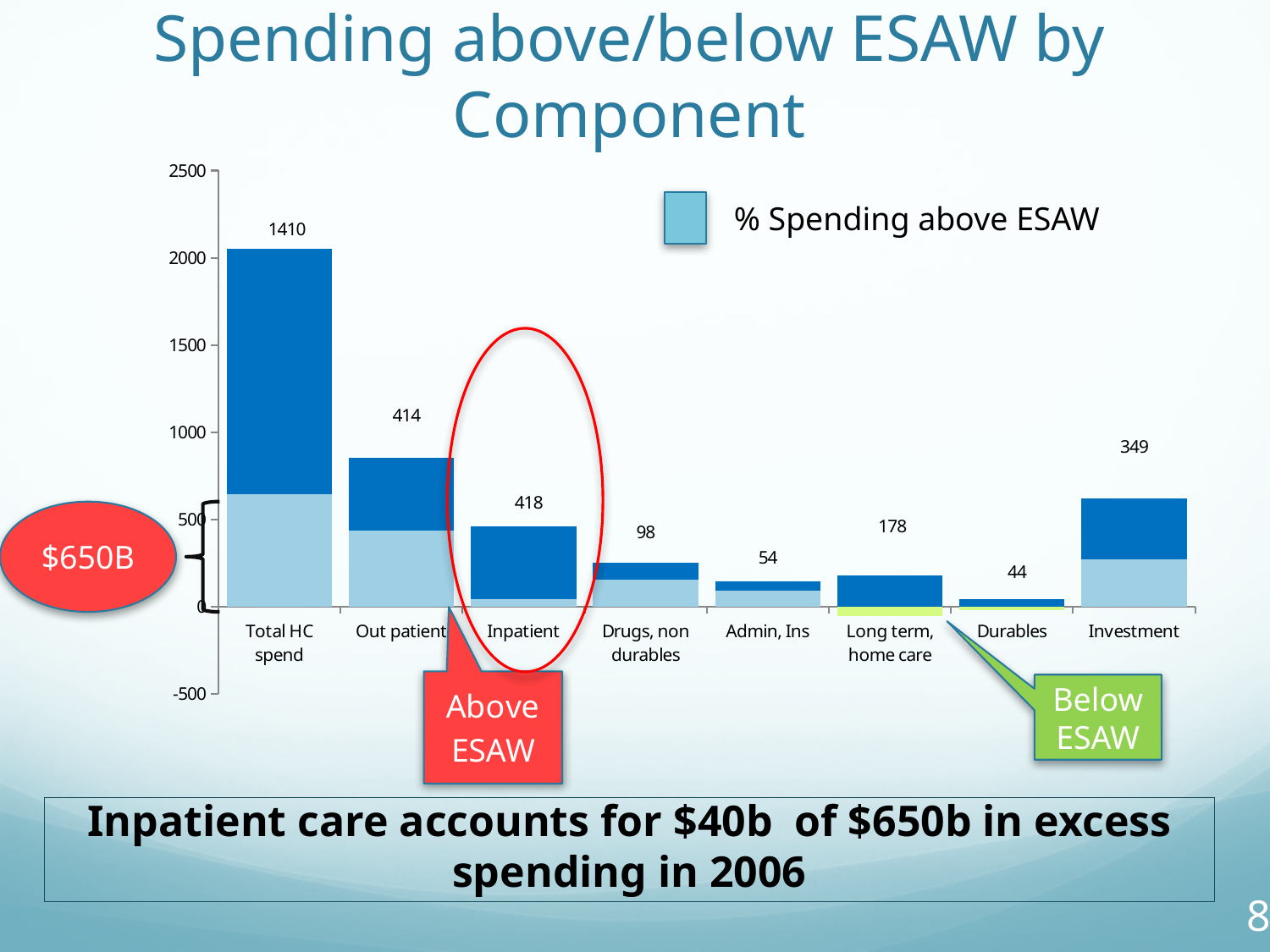
What is the title of the chart on the slide? Spending above/below ESAW by Component What is the difference between the labelled values for Investment and Long term, home care? 171 What kind of chart is shown on the slide? bar chart Which has the larger labelled value, Out patient or Durables? Out patient What is the data label shown above the Long term, home care bar? 178 What is the data label shown above the Investment bar? 349 Is the top of the Total HC spend bar greater or less than 2000? greater What is the difference between the labelled values for Drugs, non durables and Admin, Ins? 44 Which category has the lowest labelled value? Durables How many categories are shown on the x axis? 8 What is the data label shown above the Inpatient bar? 418 Which category has the highest labelled value? Total HC spend